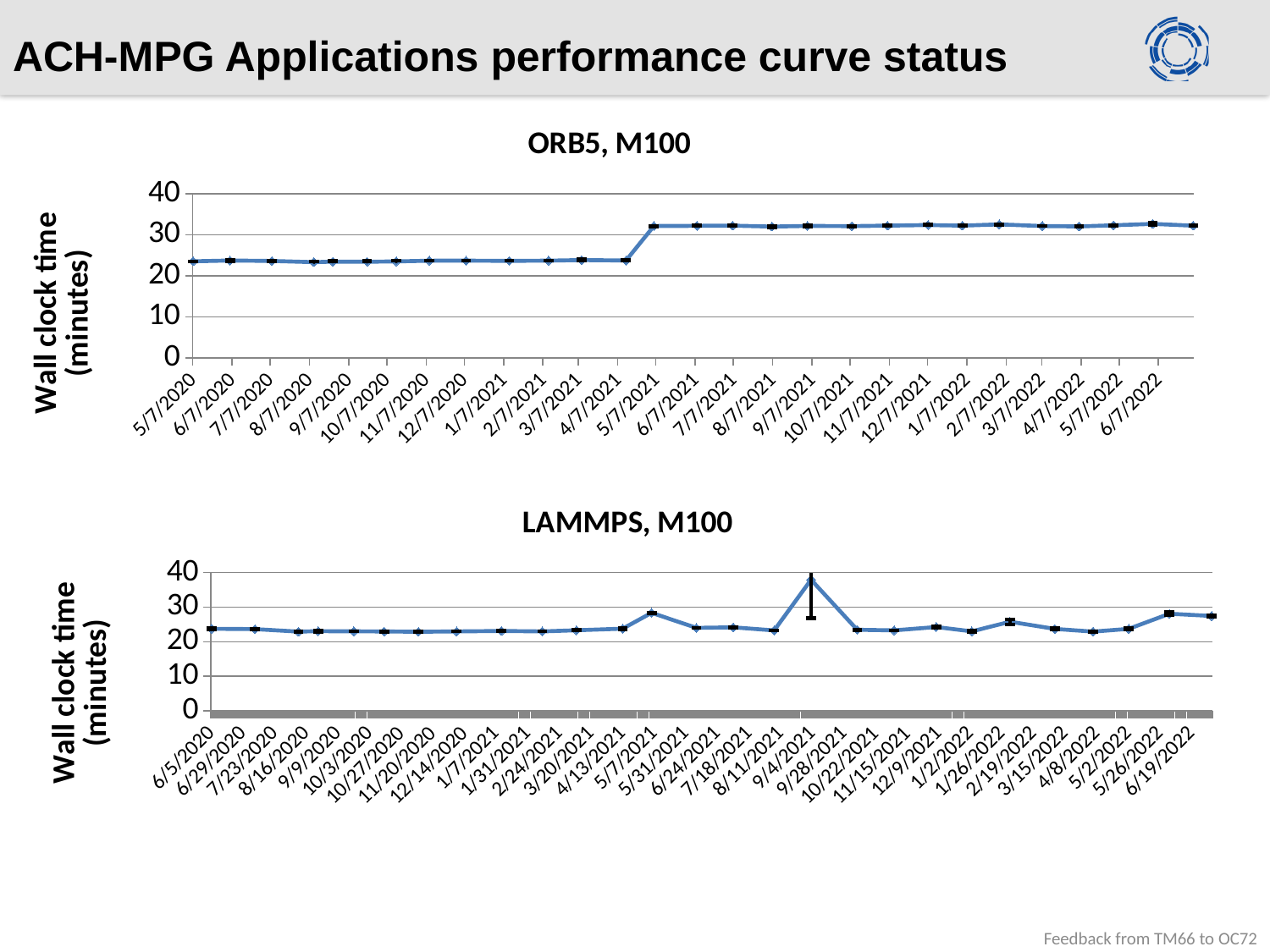
In the ORB5, M100 chart, do the values overall rise or fall from 5/7/2020 to 6/7/2022? rise In the LAMMPS, M100 chart, which date has the highest wall clock time? 9/4/2021 What kind of chart is the ORB5, M100 chart? line chart In the LAMMPS, M100 chart, is the value for 6/5/2020 greater or less than 30? less What kind of chart is the LAMMPS, M100 chart? line chart In the ORB5, M100 chart, is the value for 5/7/2020 greater or less than 30? less In the LAMMPS, M100 chart, is the value for 9/4/2021 greater or less than 30? greater In the ORB5, M100 chart, which is larger, the value for 5/7/2020 or the value for 6/7/2022? 6/7/2022 In the LAMMPS, M100 chart, which is larger, the value for 8/11/2021 or the value for 9/4/2021? 9/4/2021 What is the y-axis label of the LAMMPS, M100 chart? Wall clock time (minutes)